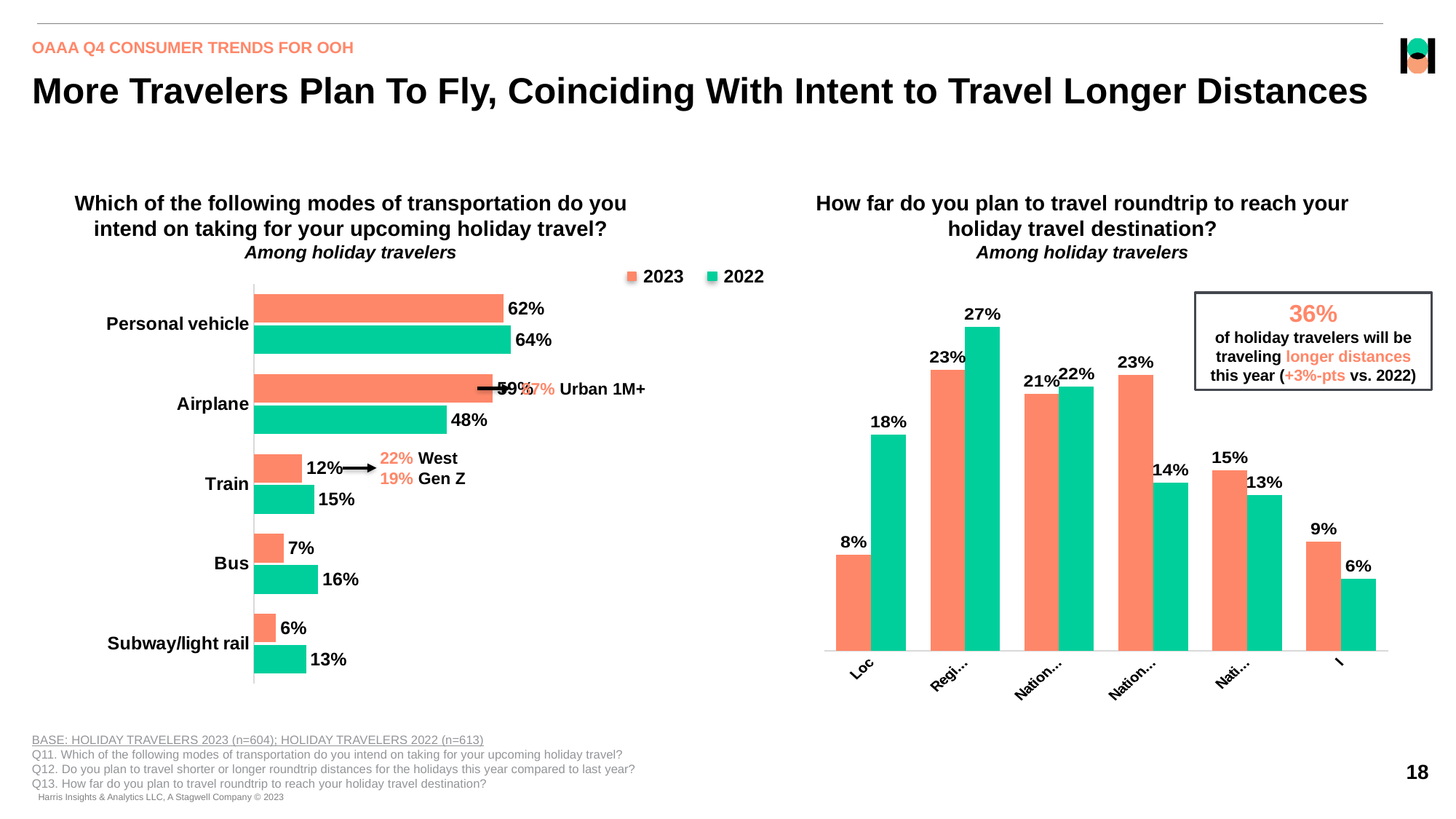
In the modes of transportation chart, by how many percentage points did the Airplane value change from 2022 (48%) to 2023 (59%)? 11 percentage points In the modes of transportation chart, which mode has the highest 2023 value? Personal vehicle How many modes of transportation are listed in the left chart? 5 In the chart 'Which of the following modes of transportation do you intend on taking for your upcoming holiday travel?', what percentage of holiday travelers intend to take a personal vehicle in 2023? 62% What type of chart is the 'How far do you plan to travel roundtrip' chart on the right? Bar chart In the modes of transportation chart, which mode has the lowest 2022 value? Subway/light rail According to the callout box on the right chart, what percentage of holiday travelers will be traveling longer distances this year? 36% How many series does the legend list for the modes of transportation chart? 2 In the modes of transportation chart, what was the 2022 value for Bus? 16% In the modes of transportation chart, which has the larger 2023 value: Train or Bus? Train In the 'How far do you plan to travel roundtrip' chart, what is the highest 2022 value shown? 27% In the modes of transportation chart, what was the 2022 value for Airplane? 48%